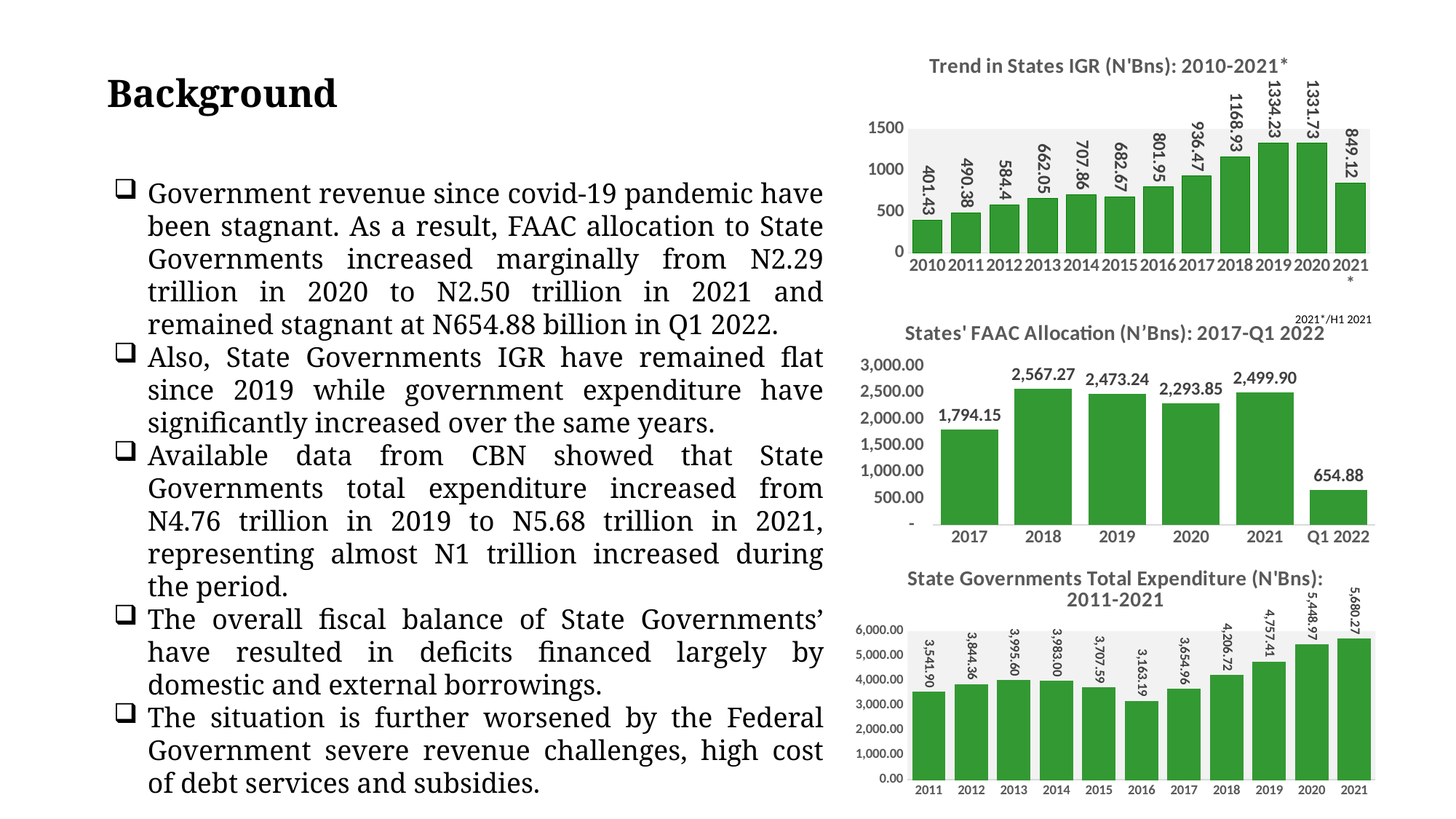
How many bars are plotted in the 'States' FAAC Allocation (N'Bns): 2017-Q1 2022' chart? 6 In the 'Trend in States IGR (N'Bns): 2010-2021*' chart, which year has the highest value? 2019 In the 'States' FAAC Allocation (N'Bns): 2017-Q1 2022' chart, what is the value for 2020? 2,293.85 How many bars are plotted in the 'Trend in States IGR (N'Bns): 2010-2021*' chart? 12 In the 'States' FAAC Allocation (N'Bns): 2017-Q1 2022' chart, which period has the highest value? 2018 In the 'States' FAAC Allocation (N'Bns): 2017-Q1 2022' chart, what is the difference between the 2021 and 2020 values? 206.05 In the 'Trend in States IGR (N'Bns): 2010-2021*' chart, what is the value for 2017? 936.47 In the 'State Governments Total Expenditure (N'Bns): 2011-2021' chart, what is the value for 2016? 3,163.19 What type of chart is the 'State Governments Total Expenditure (N'Bns): 2011-2021' chart? Bar chart In the 'State Governments Total Expenditure (N'Bns): 2011-2021' chart, which year has the lowest value? 2016 In the 'State Governments Total Expenditure (N'Bns): 2011-2021' chart, is the value for 2019 larger than the value for 2018? Yes In the 'Trend in States IGR (N'Bns): 2010-2021*' chart, which year has the lowest value? 2010